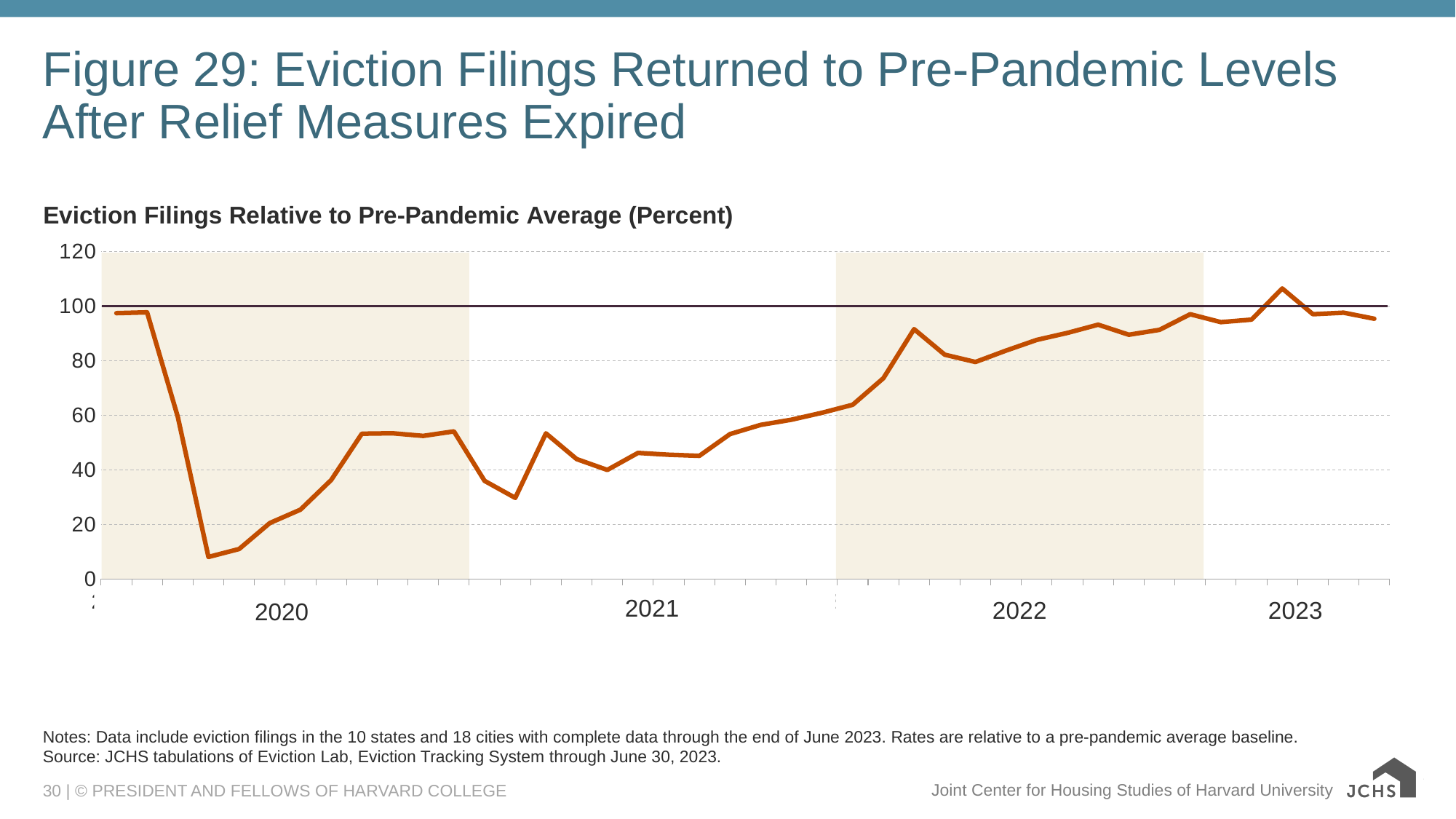
In which year labeled on the x axis does the line reach its lowest point? 2020 Is the value at the start of 2020 larger or smaller than the value at the start of 2021? larger At what value on the y axis is the horizontal reference line drawn? 100 What is the title printed directly above the chart? Eviction Filings Relative to Pre-Pandemic Average (Percent) How many years are labeled on the x axis? 4 In which year labeled on the x axis does the line reach its highest point? 2023 Is the peak value reached in 2023 greater or less than 100? greater What kind of chart is shown on the slide? line chart Is the lowest value of the line in 2020 greater or less than 20? less Is the value at the start of 2021 greater or less than 60? less Does the line generally rise or fall between the start of 2021 and the start of 2022? rise